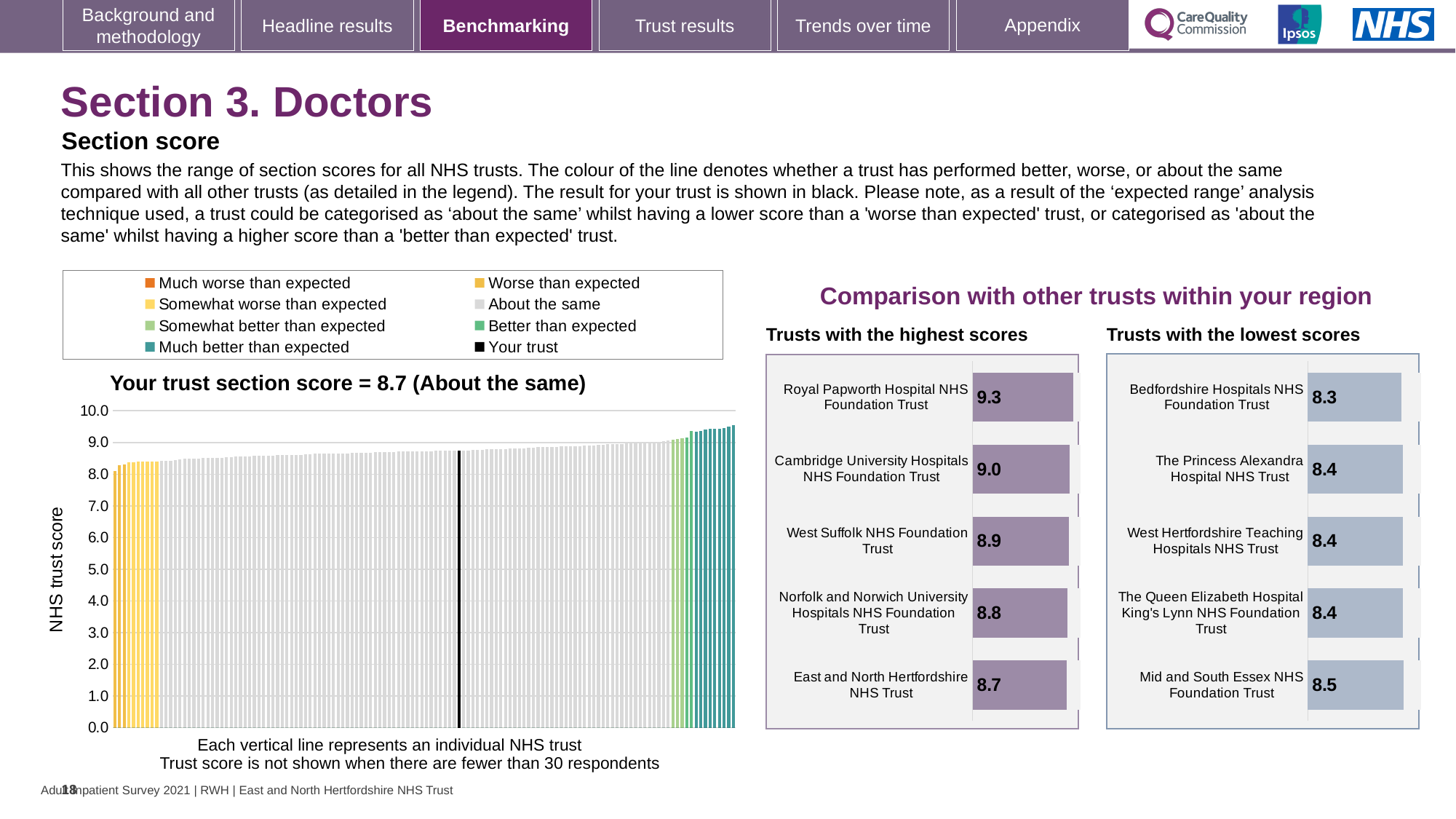
In the 'Your trust section score' chart, what category is your trust placed in? About the same In the 'Your trust section score' chart, is the value of the highest bar greater or less than 10.0? less In the 'Trusts with the highest scores' chart, what is the score for Royal Papworth Hospital NHS Foundation Trust? 9.3 In the 'Your trust section score' chart, do the trust scores rise or fall from left to right along the x axis? Rise In the 'Trusts with the highest scores' chart, which trust has the lowest score? East and North Hertfordshire NHS Trust How many entries does the legend above the 'Your trust section score' chart list? 8 In the 'Trusts with the lowest scores' chart, which trust has the lowest score? Bedfordshire Hospitals NHS Foundation Trust In the 'Your trust section score' chart, what is the section score for your trust? 8.7 How many trusts are shown in the 'Trusts with the lowest scores' chart? 5 What kind of chart is the 'Your trust section score' chart? Bar chart In the 'Trusts with the lowest scores' chart, which has the higher score: Bedfordshire Hospitals NHS Foundation Trust or Mid and South Essex NHS Foundation Trust? Mid and South Essex NHS Foundation Trust In the 'Trusts with the highest scores' chart, what is the difference between the scores of Royal Papworth Hospital NHS Foundation Trust and East and North Hertfordshire NHS Trust? 0.6